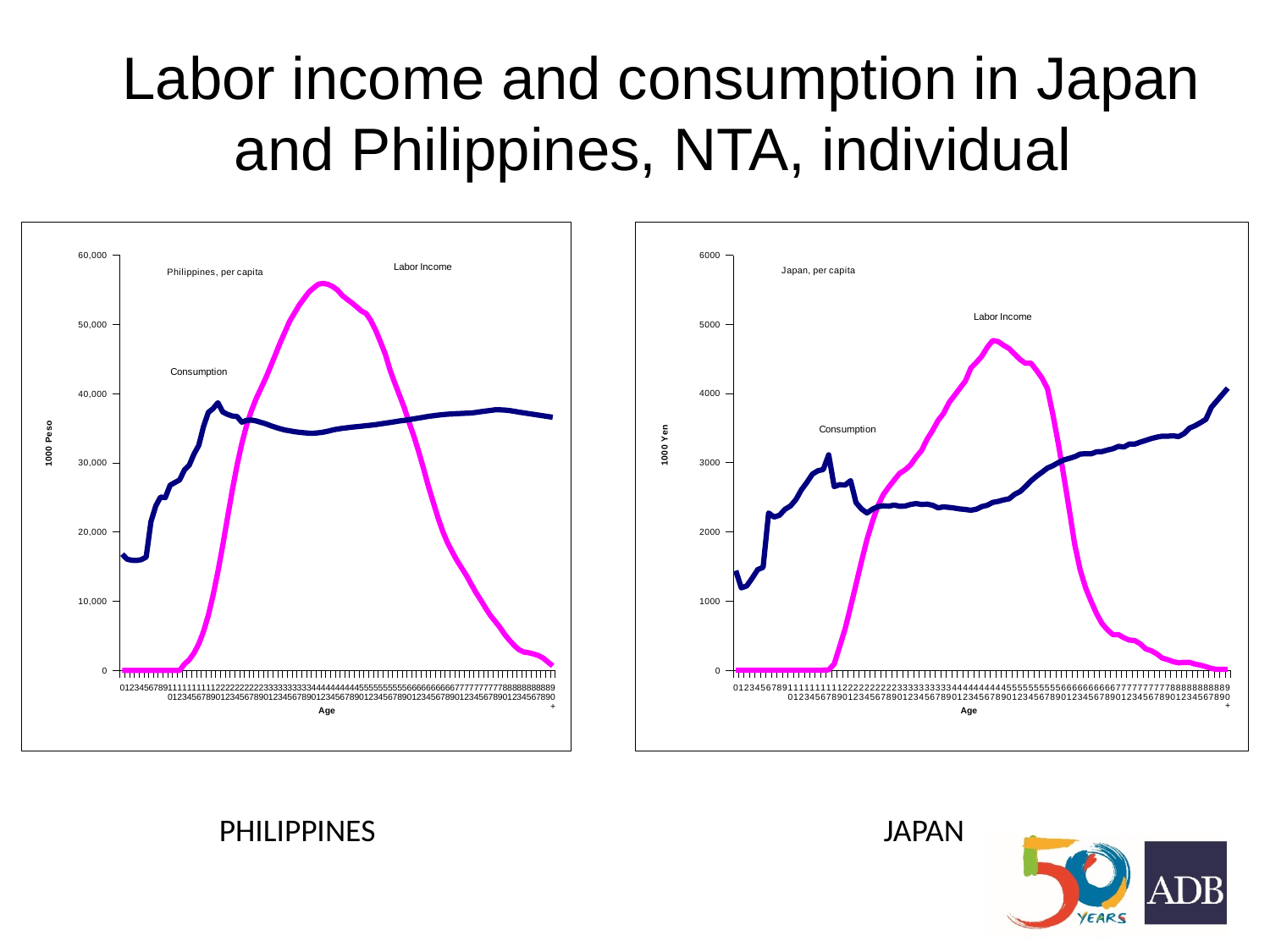
In the Japan, per capita chart, is Consumption at age 0 greater or less than 2000? less In the Philippines, per capita chart, is Consumption at age 0 greater or less than 20,000? less What is the y-axis label of the Japan, per capita chart? 1000 Yen What kind of chart is the Philippines, per capita chart on the left? line chart In the Philippines, per capita chart, does Labor Income rise or fall between age 50 and age 90? fall In the Philippines, per capita chart, is the peak value of Labor Income greater or less than 50,000? greater How many series are plotted in the Japan, per capita chart on the right? 2 In the Philippines, per capita chart, which series is higher at age 40, Labor Income or Consumption? Labor Income In the Japan, per capita chart, which series is higher at age 80, Labor Income or Consumption? Consumption In the Japan, per capita chart, does Consumption rise or fall between age 40 and age 90? rise